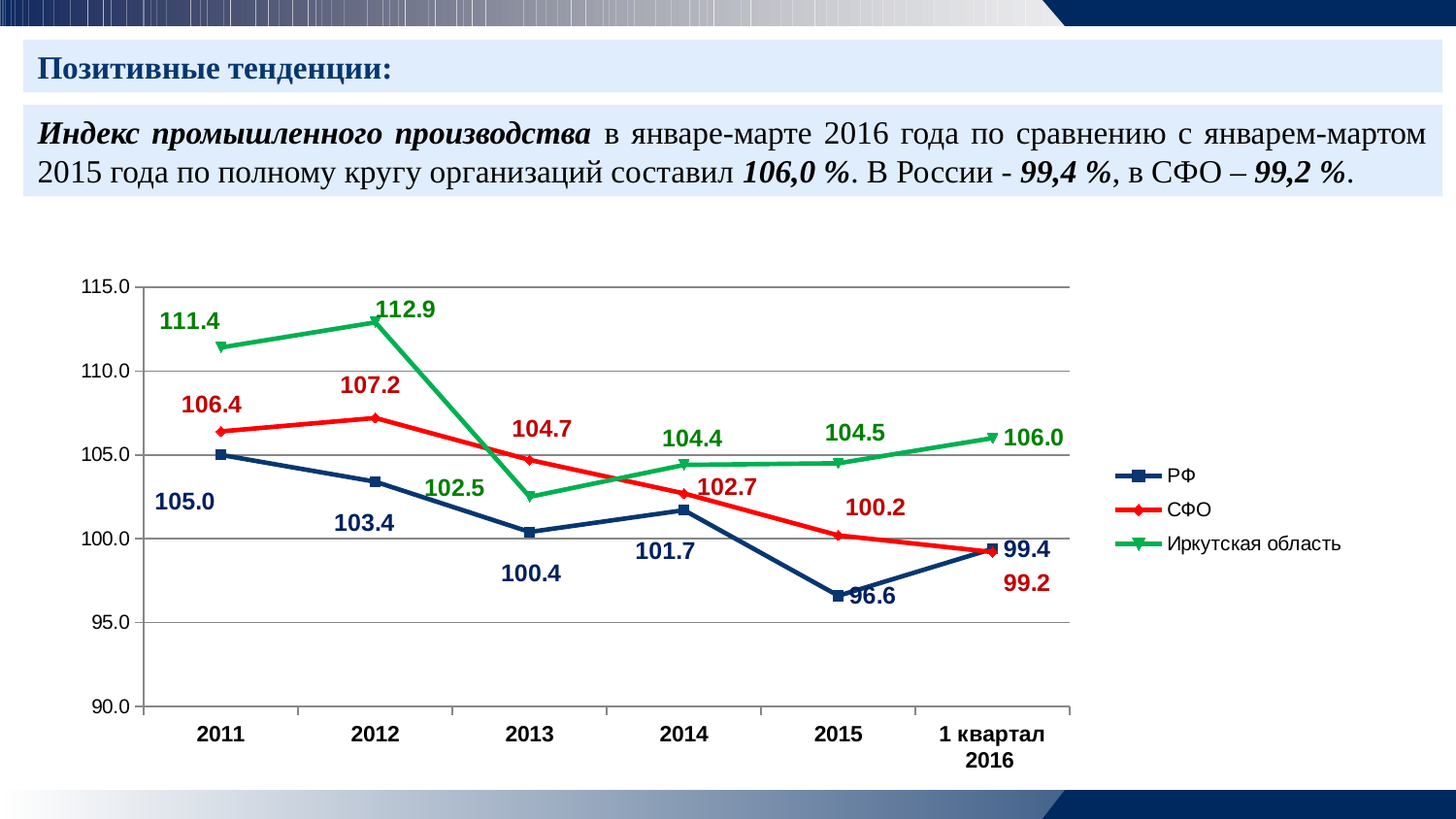
What is the value for РФ in 2015? 96.6 What is the difference between the Иркутская область value and the РФ value in 2011? 6.4 How many points are plotted along the x axis for each series? 6 What kind of chart is shown on the slide? line chart Which is larger in 2013: the value for СФО or the value for Иркутская область? СФО What is the value for Иркутская область in 2012? 112.9 Which series is drawn in green? Иркутская область What is the value for СФО in 2014? 102.7 Does the СФО series rise or fall from 2012 to 1 квартал 2016? fall How many series does the legend list? 3 In which year does the Иркутская область series reach its highest value? 2012 In which year does the РФ series reach its lowest value? 2015